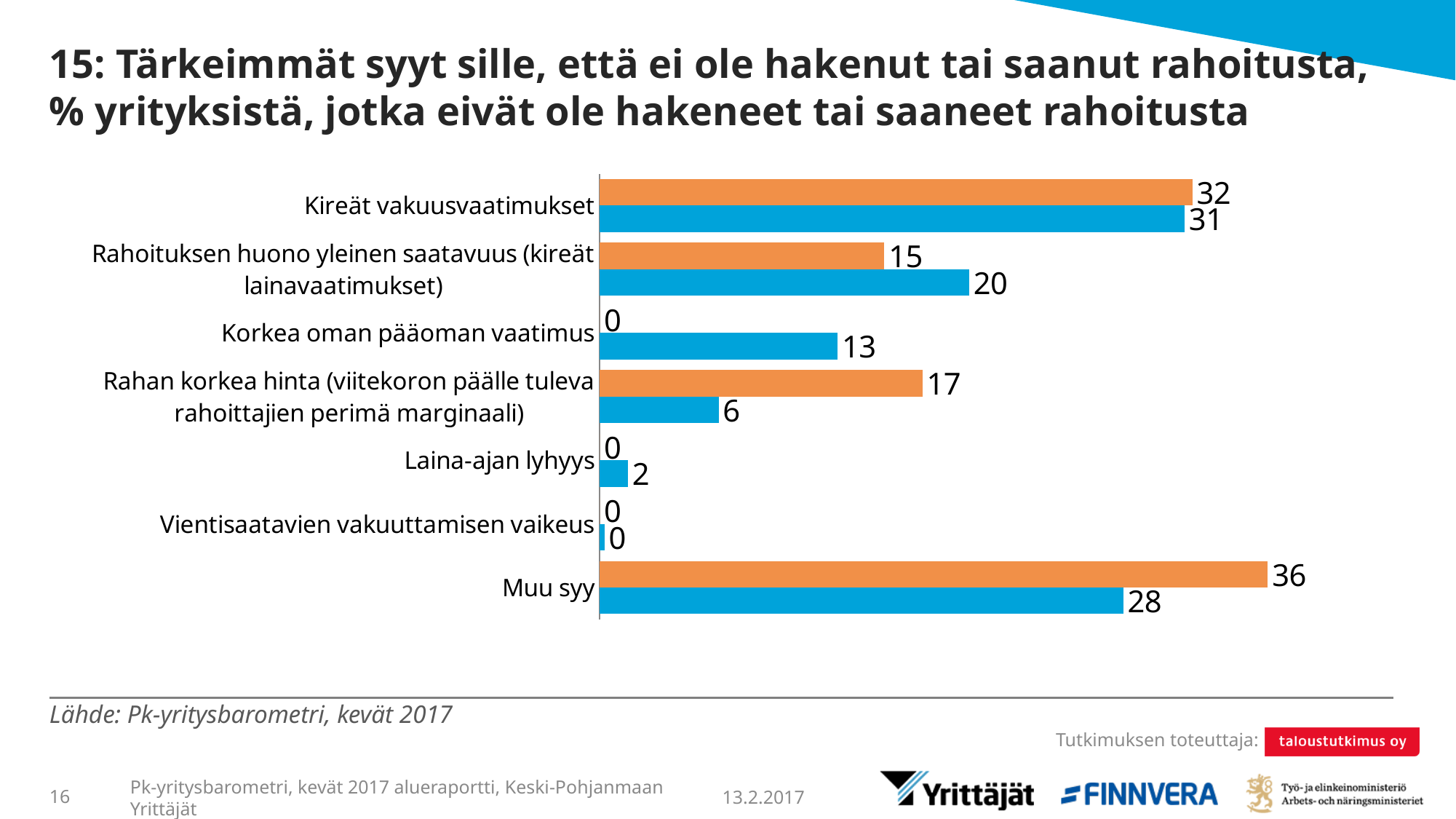
What is the difference between the orange and blue bars for Muu syy? 8 What is the value of the blue bar for Korkea oman pääoman vaatimus? 13 What colours are the two series of bars in the chart? orange and blue What is the value of the blue bar for Laina-ajan lyhyys? 2 What type of chart is shown on the slide? bar chart How many categories are shown on the chart? 7 What is the value of the orange bar for Rahan korkea hinta (viitekoron päälle tuleva rahoittajien perimä marginaali)? 17 What is the value of the blue bar for Rahoituksen huono yleinen saatavuus (kireät lainavaatimukset)? 20 For Rahan korkea hinta (viitekoron päälle tuleva rahoittajien perimä marginaali), which bar is larger, orange or blue? orange Which category has the highest value among the orange bars? Muu syy What is the value of the orange bar for Kireät vakuusvaatimukset? 32 Which category has the lowest value among the blue bars? Vientisaatavien vakuuttamisen vaikeus